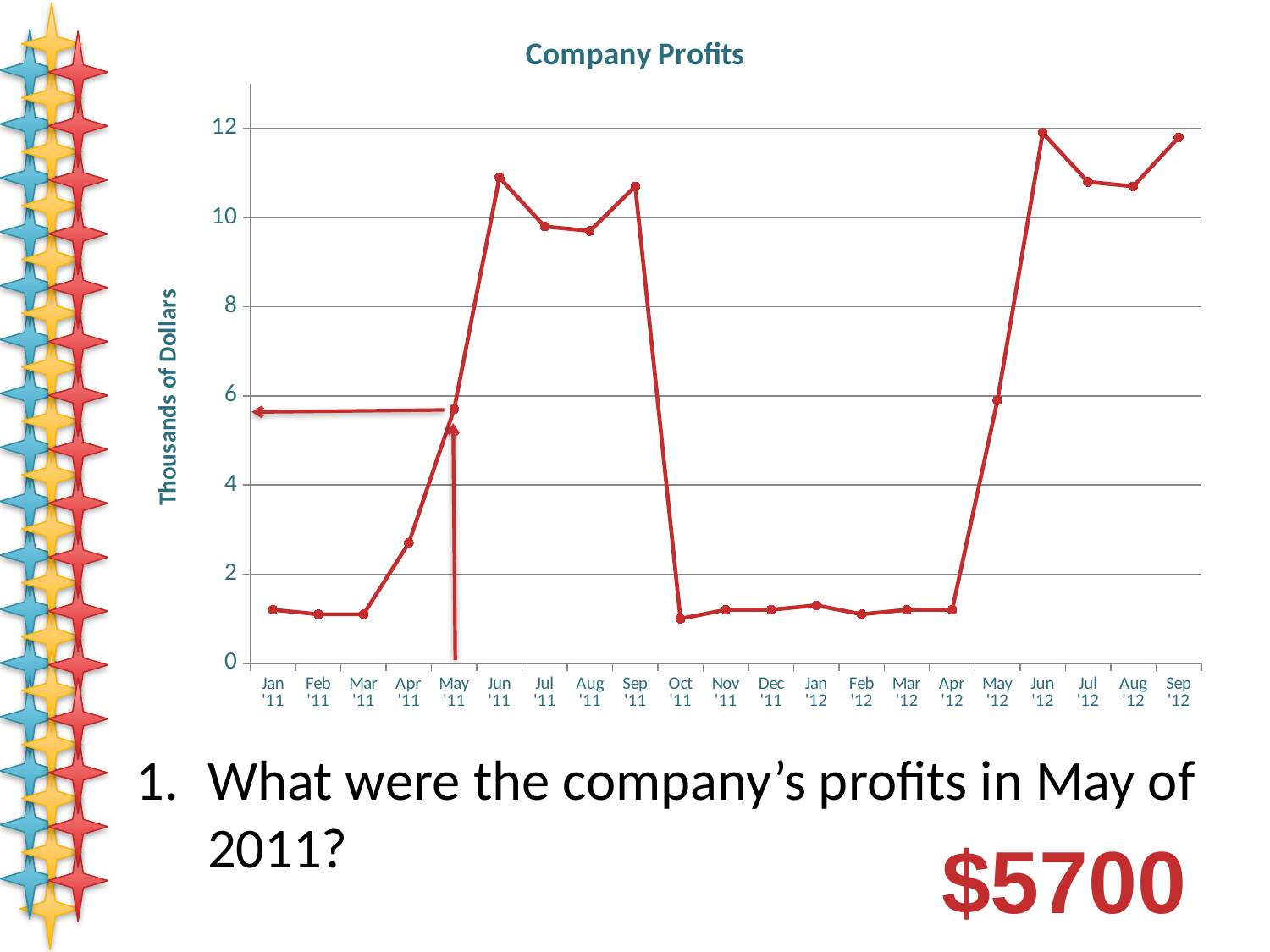
Is the value for Oct '11 greater or less than 2? less What is the label on the vertical axis of the chart? Thousands of Dollars What is the title of the chart? Company Profits Is the value for May '12 greater or less than 4? greater Is the value for Jun '11 greater or less than 10? greater Do the values rise or fall from Mar '11 to Jun '11? rise Which is larger, the value for Sep '11 or the value for Oct '11? Sep '11 Which is larger, the value for Jun '11 or the value for Jul '11? Jun '11 According to the slide, what were the company's profits in May of 2011? $5700 How many monthly data points are plotted on the chart? 21 What type of chart is shown on the slide? line chart